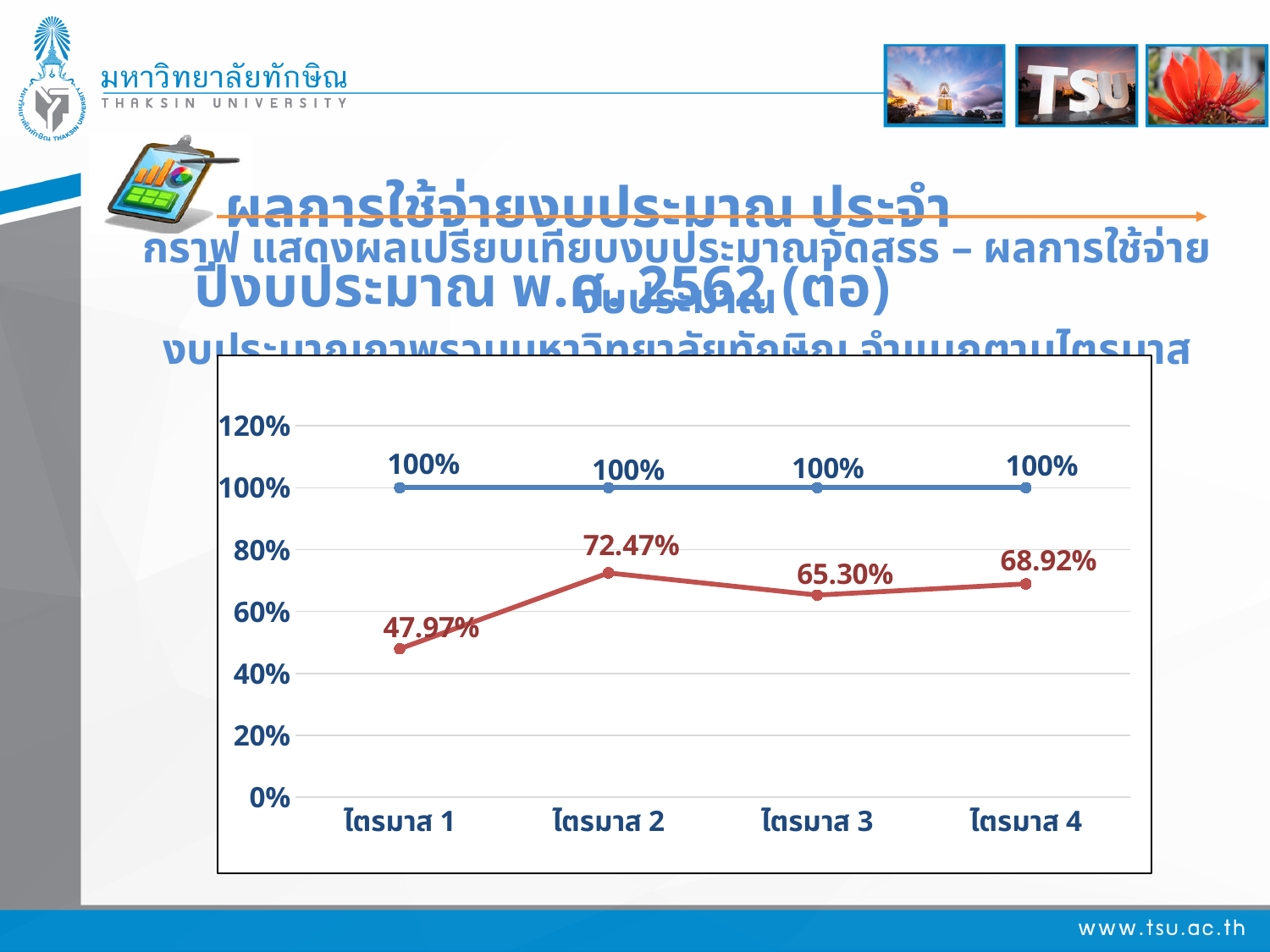
What is the value of the blue line at ไตรมาส 3? 100% What is the value of the red line at ไตรมาส 1? 47.97% How many quarters (categories) are shown on the x axis? 4 In which quarter does the red line reach its highest value? ไตรมาส 2 What type of chart is shown on the slide? line chart What is the difference between the red line's values at ไตรมาส 2 and ไตรมาส 1? 24.50% What is the value of the red line at ไตรมาส 2? 72.47% What is the value of the red line at ไตรมาส 4? 68.92% What is the value of the red line at ไตรมาส 3? 65.30% In which quarter does the red line have its lowest value? ไตรมาส 1 What is the difference between the blue line and the red line at ไตรมาส 4? 31.08% Which is larger, the red line's value at ไตรมาส 3 or at ไตรมาส 4? ไตรมาส 4